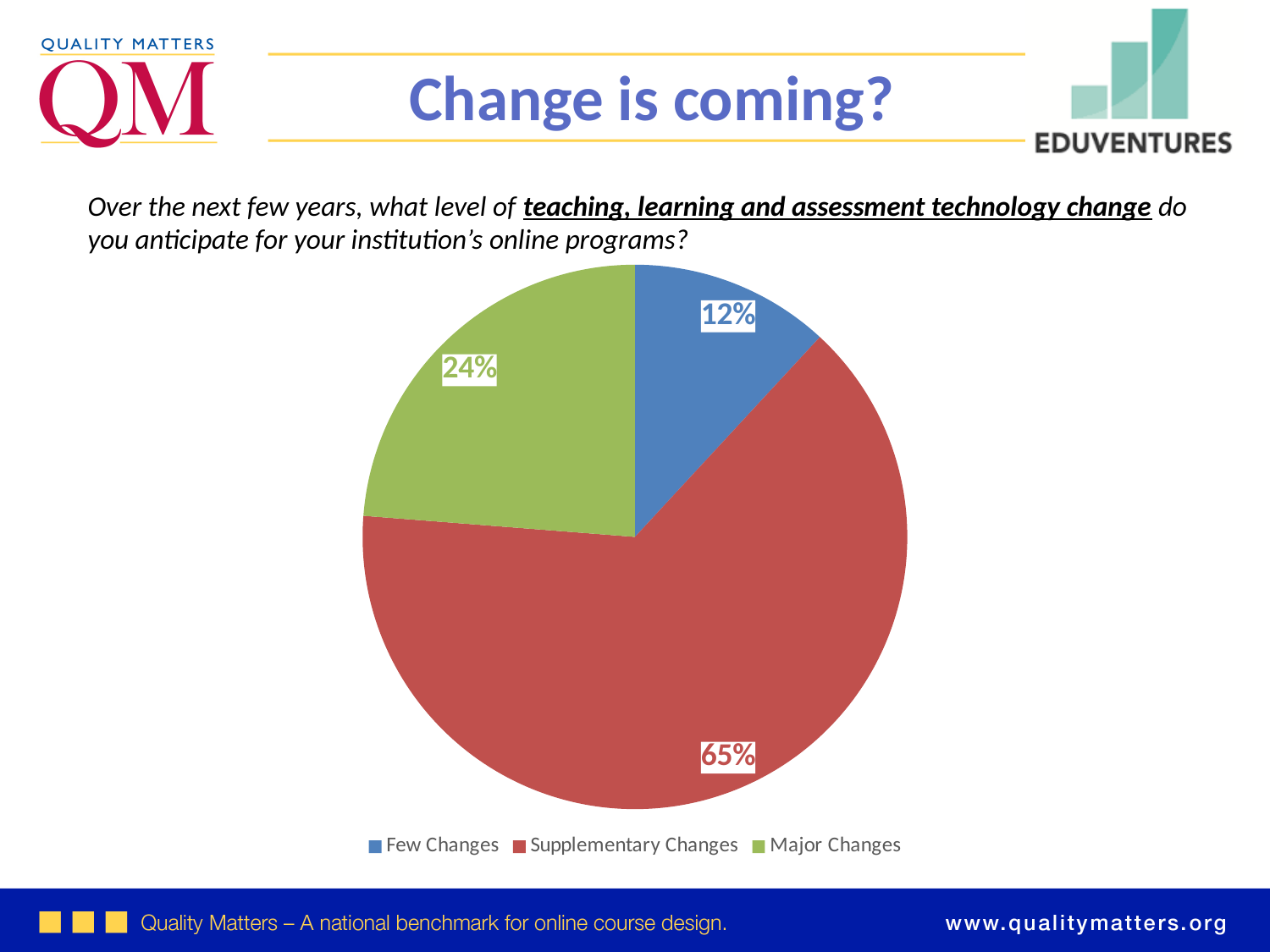
How many categories does the pie chart show? 3 Which category has the largest share of the pie? Supplementary Changes What is the title of the slide containing the pie chart? Change is coming? Which category has the smallest share of the pie? Few Changes What kind of chart is shown on the slide? pie chart What percentage of respondents anticipate Few Changes? 12% Which is larger, the share for Major Changes or the share for Few Changes? Major Changes What is the difference in percentage points between Supplementary Changes and Major Changes? 41 What percentage of respondents anticipate Supplementary Changes? 65% What percentage of respondents anticipate Major Changes? 24% What colour is the Supplementary Changes slice? red What is the difference in percentage points between Major Changes and Few Changes? 12